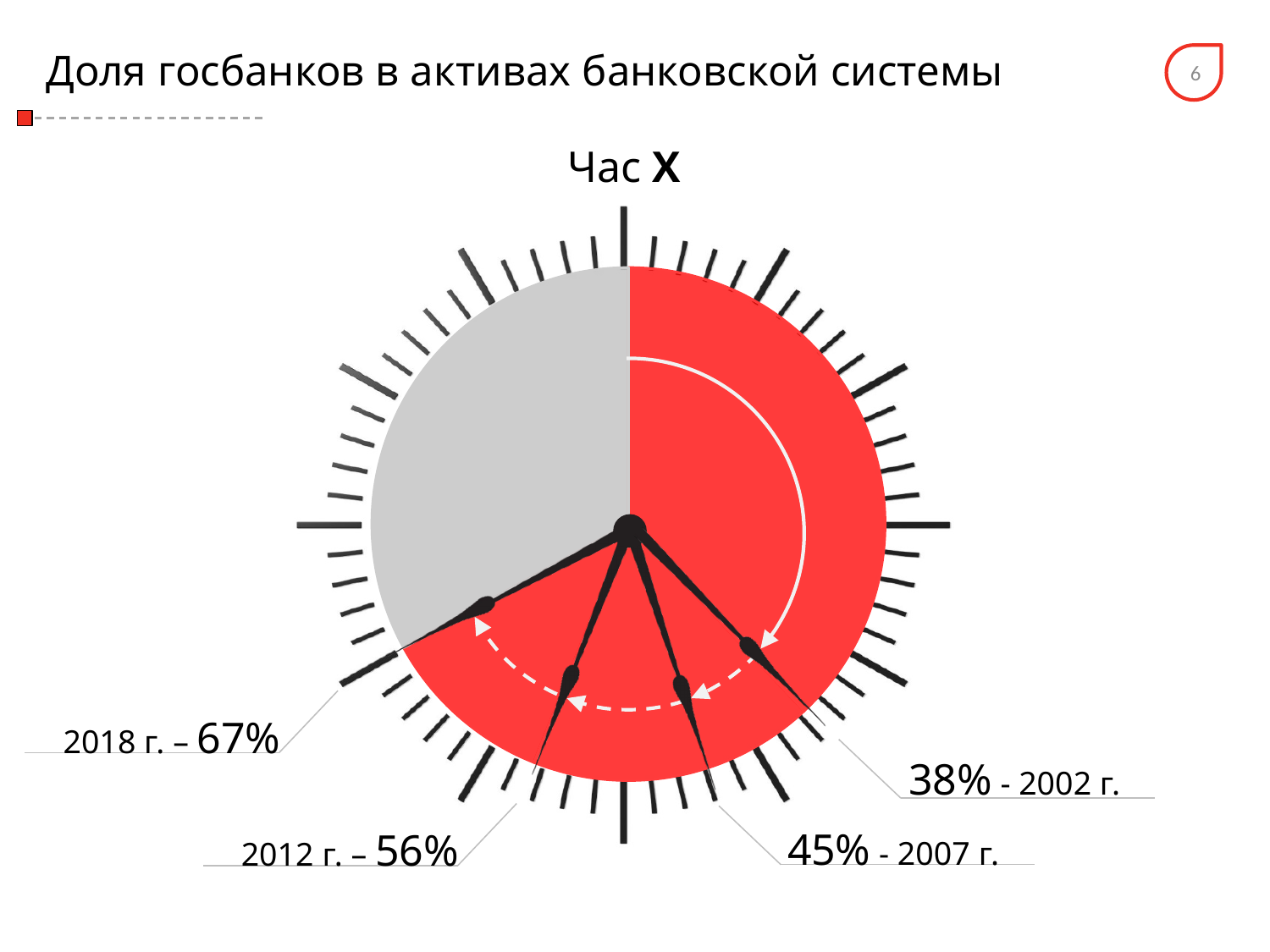
Which year has the highest share of state banks in banking system assets? 2018 How many years are labelled on the chart? 4 What is the difference between the 2012 and 2007 shares of state banks? 11 percentage points Does the share of state banks rise or fall over the years shown? rise By how many percentage points did the share of state banks grow from 2002 to 2018? 29 percentage points What is the title of the slide? Доля госбанков в активах банковской системы Which year has the lowest share of state banks in banking system assets? 2002 What is the share of state banks in banking system assets in 2007? 45% What is the share of state banks in banking system assets in 2012? 56% Which is larger, the share of state banks in 2007 or in 2012? 2012 What is the share of state banks in banking system assets in 2002? 38% What is the share of state banks in banking system assets in 2018? 67%